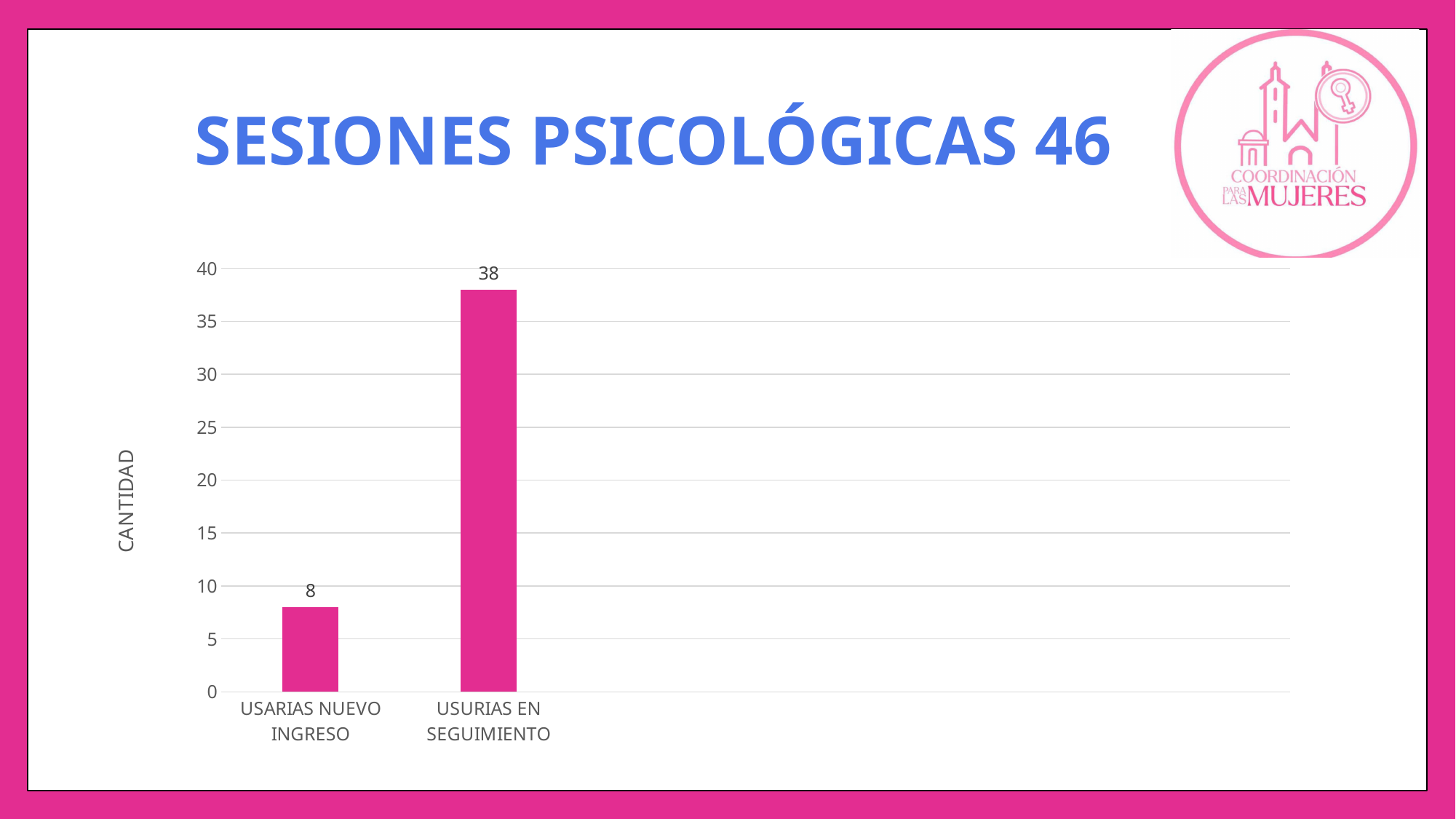
What is the value for USARIAS NUEVO INGRESO? 8 What is the label of the vertical axis of the chart? CANTIDAD Is the value for USARIAS NUEVO INGRESO greater or less than 10? less Which category has the lowest value? USARIAS NUEVO INGRESO What kind of chart is shown on the slide? bar chart What is the difference between the values for USURIAS EN SEGUIMIENTO and USARIAS NUEVO INGRESO? 30 Which is larger, the value for USARIAS NUEVO INGRESO or the value for USURIAS EN SEGUIMIENTO? USURIAS EN SEGUIMIENTO What is the title of the slide? SESIONES PSICOLÓGICAS 46 How many categories are shown on the x axis of the chart? 2 What is the value for USURIAS EN SEGUIMIENTO? 38 Is the value for USURIAS EN SEGUIMIENTO greater or less than 35? greater Which category has the highest value? USURIAS EN SEGUIMIENTO